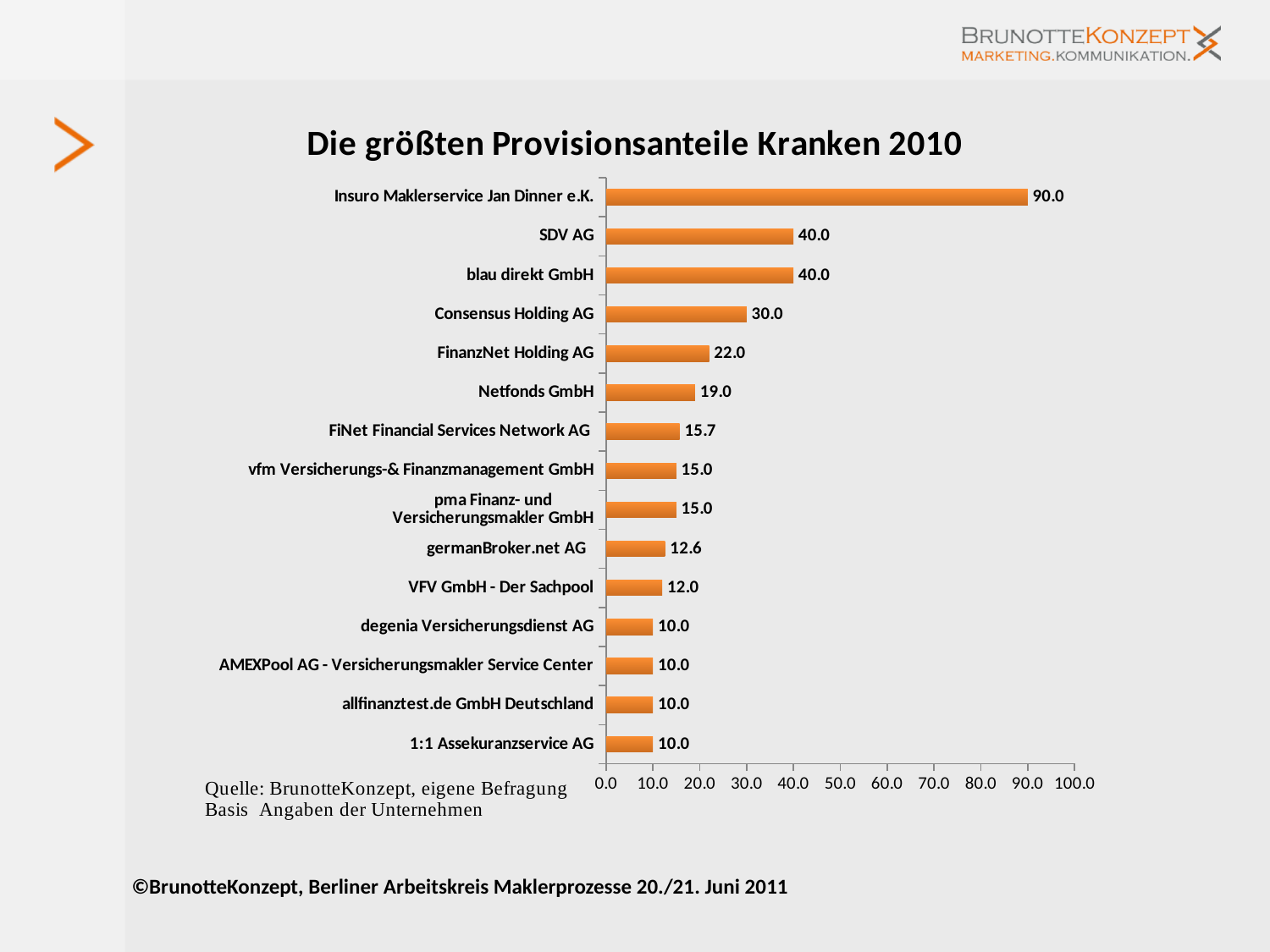
Is the value for Consensus Holding AG greater or less than 20.0? greater How many categories are shown in the chart? 15 What is the value for FiNet Financial Services Network AG? 15.7 Which category has the highest value? Insuro Maklerservice Jan Dinner e.K. What is the difference between the values for Insuro Maklerservice Jan Dinner e.K. and SDV AG? 50.0 What is the value for germanBroker.net AG? 12.6 What is the title of the chart? Die größten Provisionsanteile Kranken 2010 What is the difference between the values for Consensus Holding AG and FinanzNet Holding AG? 8.0 What kind of chart is shown on the slide? bar chart What is the value for Netfonds GmbH? 19.0 Which is larger, the value for Netfonds GmbH or the value for VFV GmbH - Der Sachpool? Netfonds GmbH What is the value for Insuro Maklerservice Jan Dinner e.K.? 90.0